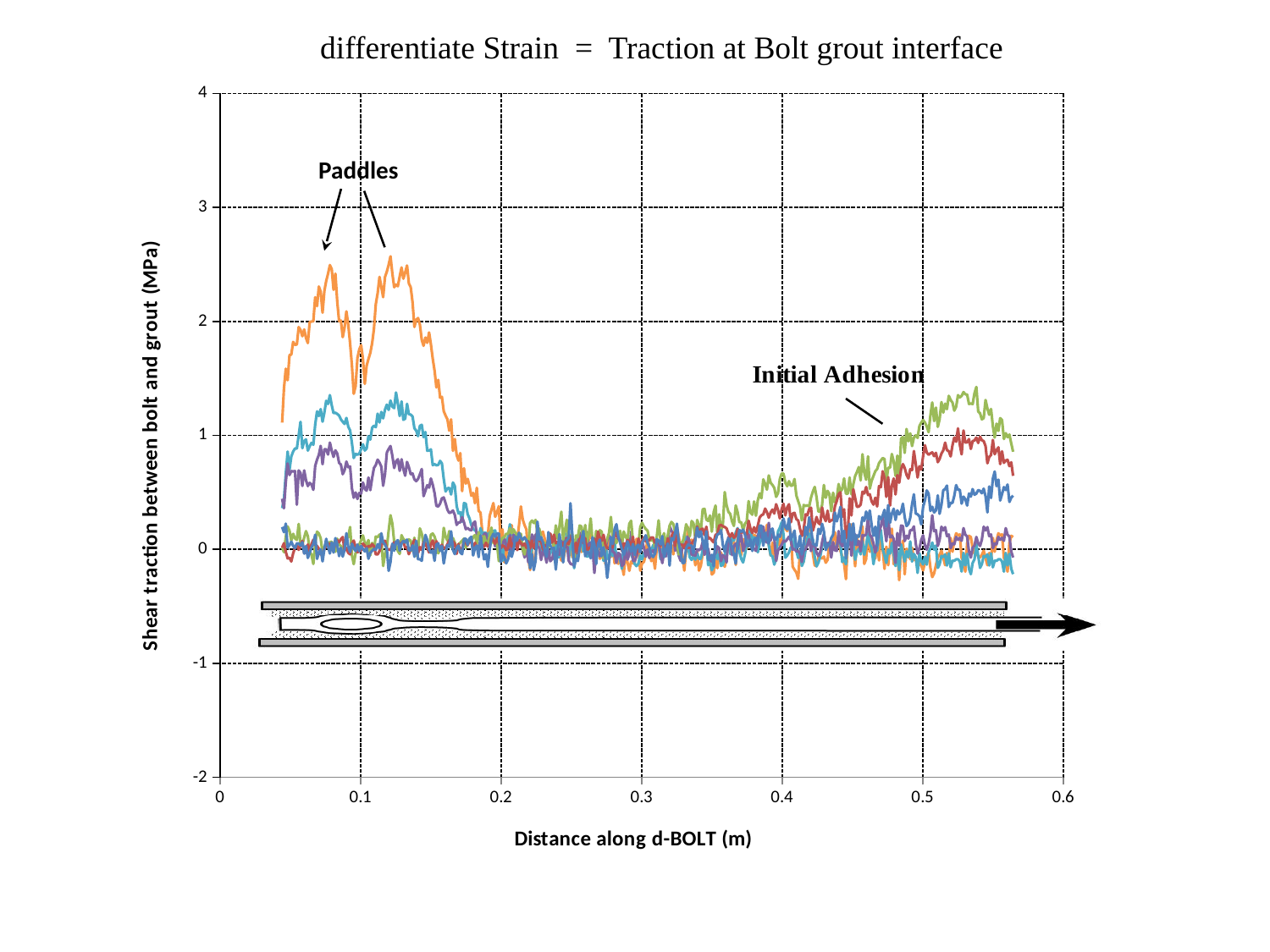
Which is larger: the highest value reached near the 'Paddles' annotation or the highest value reached near the 'Initial Adhesion' annotation? Paddles What kind of chart is shown on the slide? line chart Is the highest shear traction value reached near the 'Initial Adhesion' annotation greater or less than 2? less What is the title of the chart? differentiate Strain = Traction at Bolt grout interface Moving along the x axis from 0.15 m to 0.2 m, does the uppermost trace rise or fall? fall Is the highest shear traction value reached near the 'Paddles' annotation greater or less than 3? less Is the highest shear traction value reached near the 'Initial Adhesion' annotation greater or less than 1? greater Moving along the x axis from 0.4 m to 0.5 m, do the uppermost traces rise or fall? rise What is the label on the x axis of the chart? Distance along d-BOLT (m)